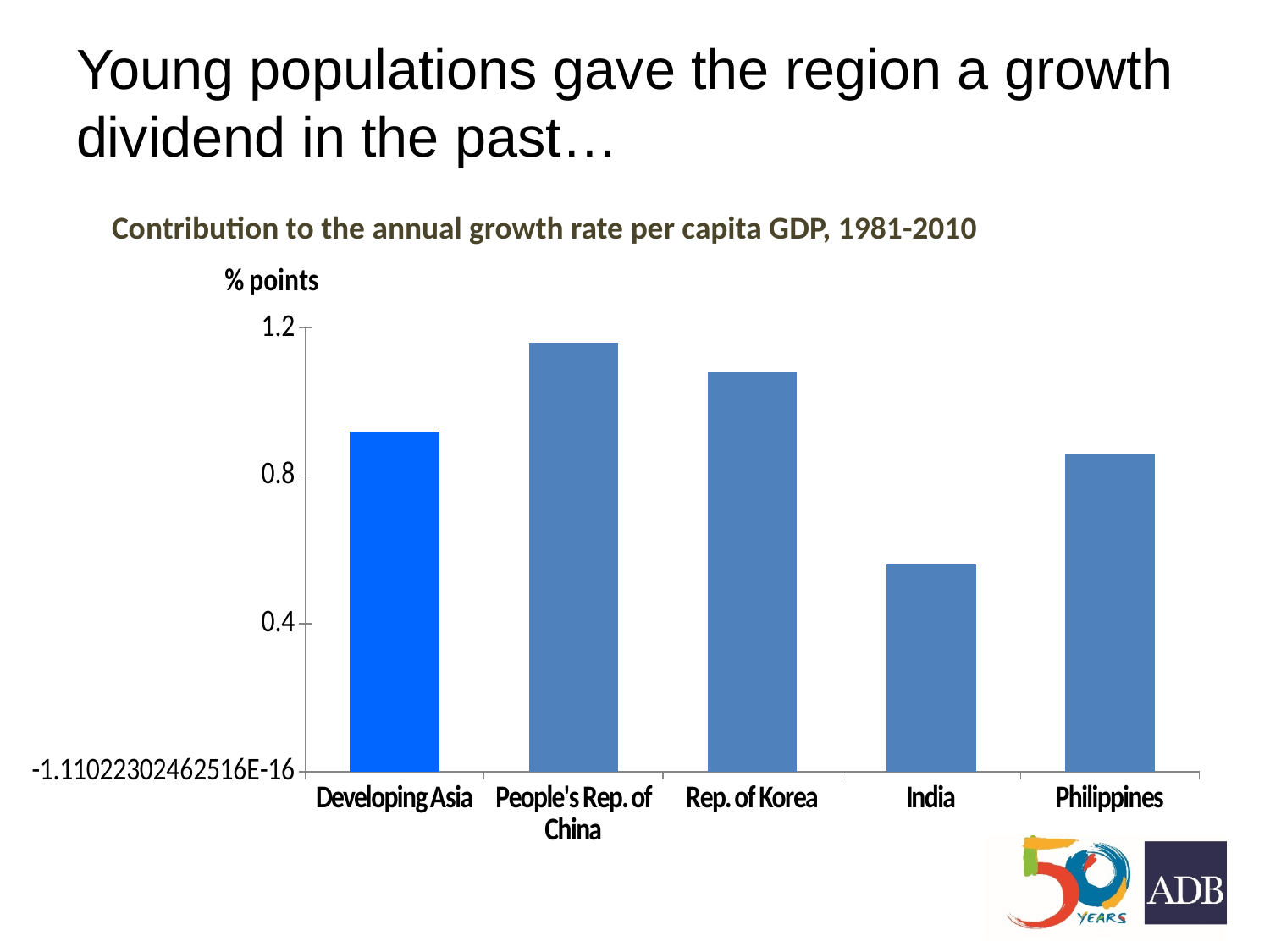
Is the value for India greater or less than 0.8? less Which category has the lowest contribution to the annual growth rate per capita GDP? India Which is larger, the value for Developing Asia or the value for India? Developing Asia Which is larger, the value for Rep. of Korea or the value for Philippines? Rep. of Korea Is the value for People's Rep. of China greater or less than 0.8? greater How many categories are shown on the x axis of the chart? 5 Which category has the highest contribution to the annual growth rate per capita GDP? People's Rep. of China What kind of chart is shown on the slide? bar chart Is the value for Developing Asia greater or less than 0.8? greater What is the title of the chart? Contribution to the annual growth rate per capita GDP, 1981-2010